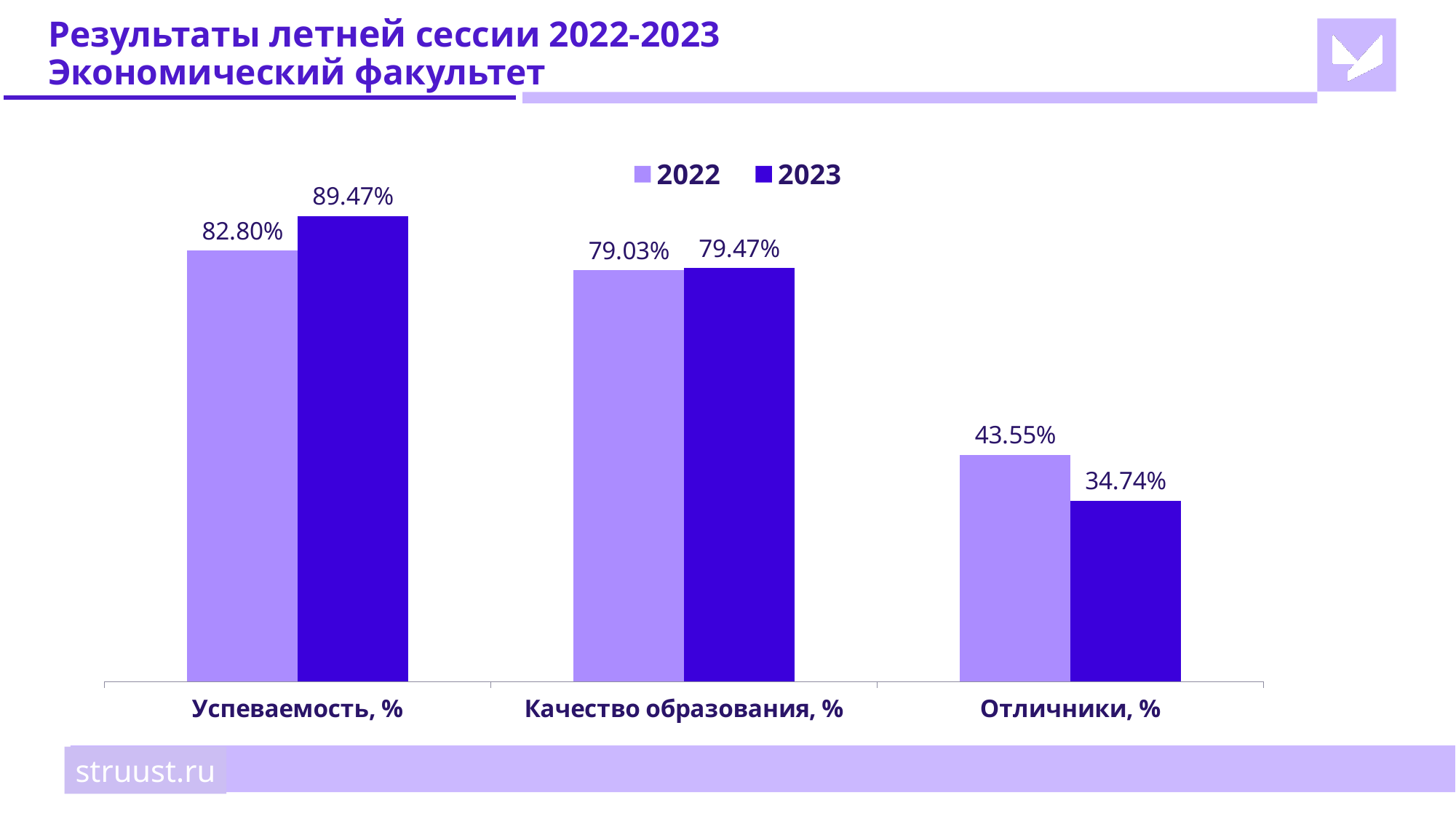
What is the 2023 value for Отличники, %? 34.74% How many categories are shown on the x axis? 3 What is the 2022 value for Отличники, %? 43.55% Which category has the lowest 2022 value? Отличники, % What is the 2022 value for Качество образования, %? 79.03% What is the 2023 value for Успеваемость, %? 89.47% For Отличники, %, which year has the larger value, 2022 or 2023? 2022 Which category has the highest 2023 value? Успеваемость, % How many series does the legend list? 2 What is the difference between the 2022 and 2023 values for Отличники, %? 8.81% What is the difference between the 2023 and 2022 values for Успеваемость, %? 6.67% What kind of chart is shown on the slide? Bar chart